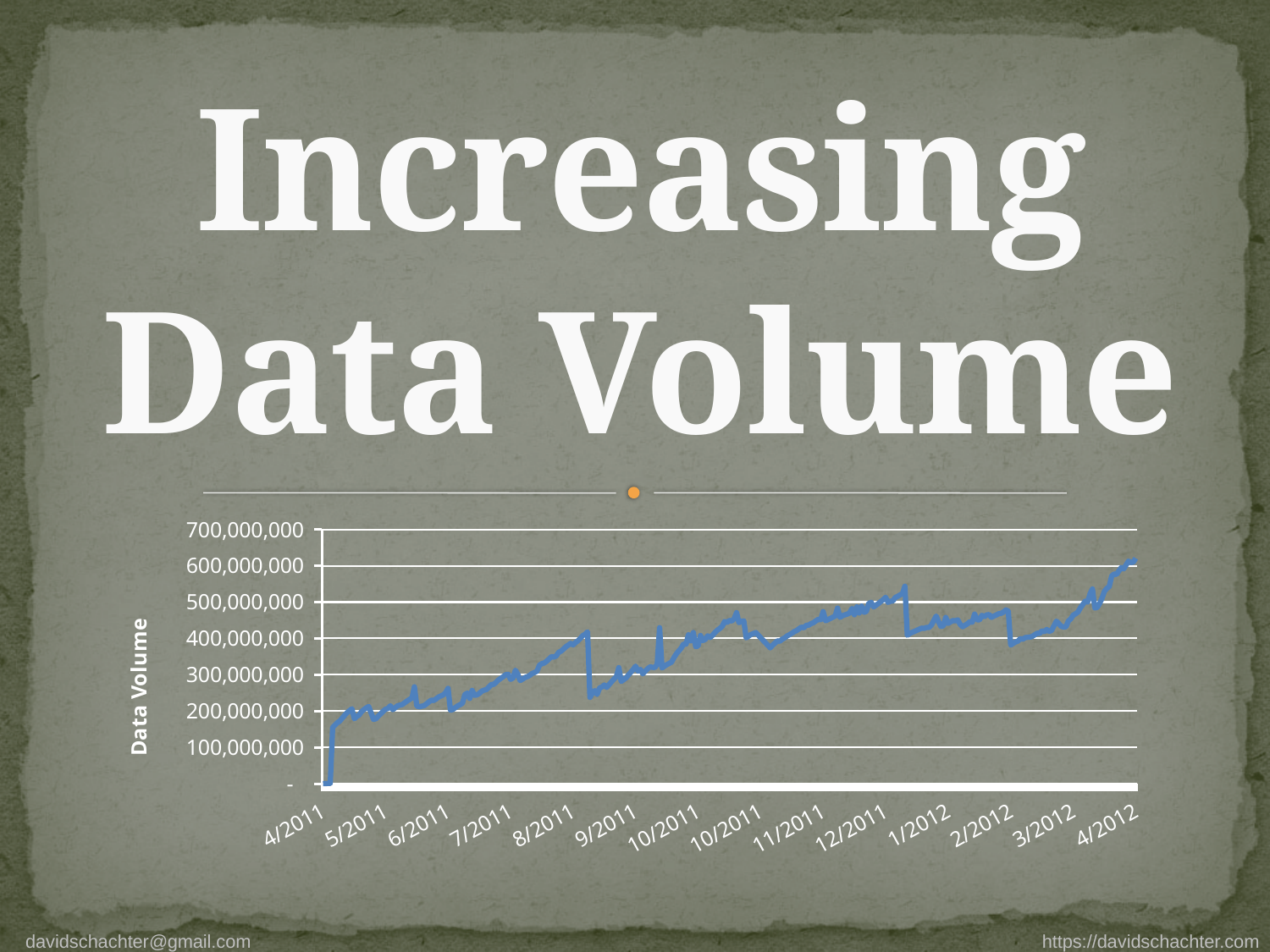
Is the value at 4/2012 greater or less than 500,000,000? greater What is the highest tick value shown on the y-axis? 700,000,000 At which x-axis label does the line reach its highest value? 4/2012 Is the value at 5/2011 greater or less than 300,000,000? less Is the value at 2/2012 greater or less than 300,000,000? greater Which is larger, the value at 4/2012 or the value at 7/2011? 4/2012 What is the title of the y-axis? Data Volume At which x-axis label does the line have its lowest value? 4/2011 What kind of chart is shown on the slide? line chart Do the values in the chart generally rise or fall from 4/2011 to 4/2012? rise